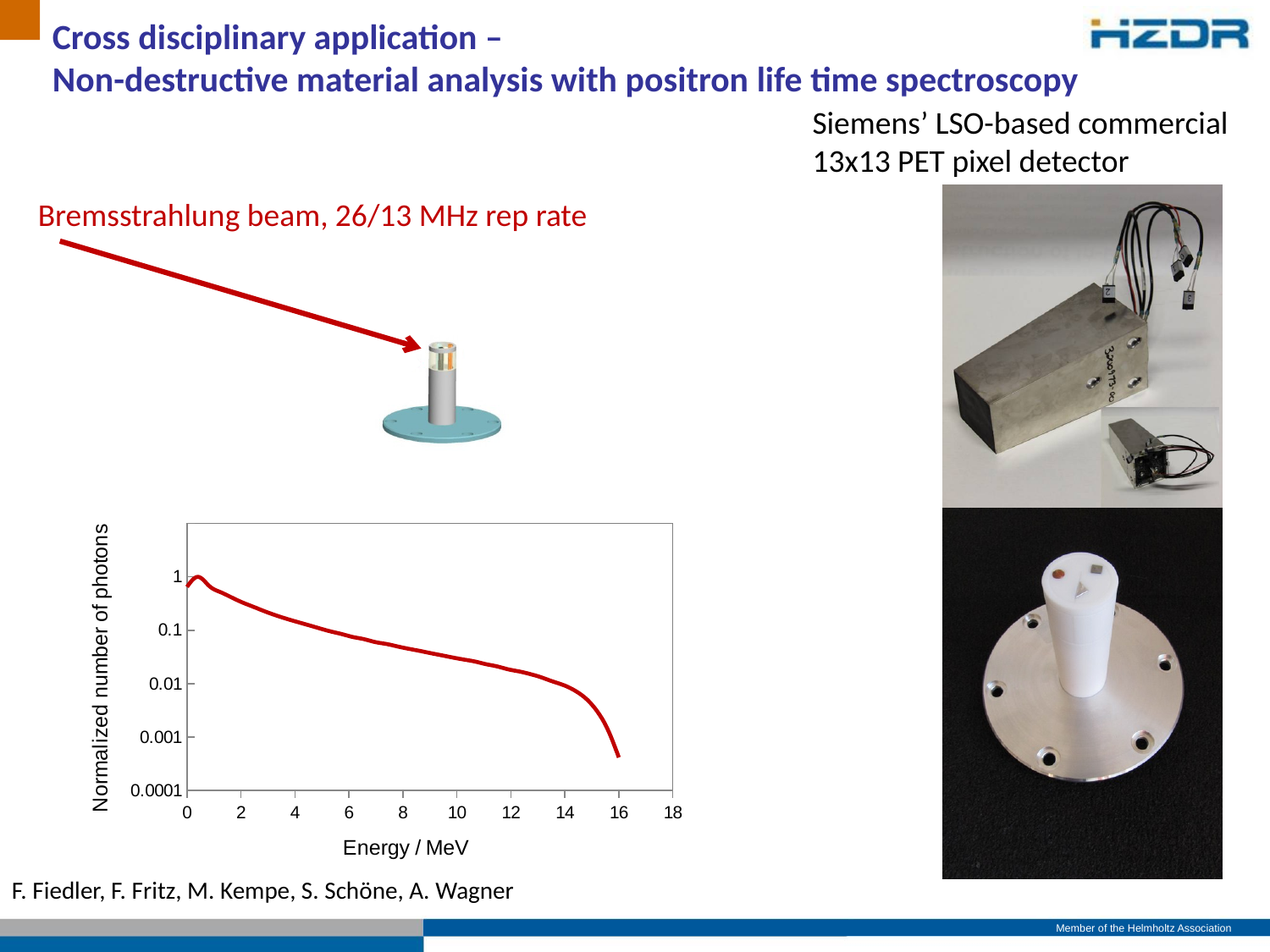
What kind of chart is shown at the bottom left of the slide? line chart How many curves are plotted on the chart? 1 What is the label of the y axis of the chart? Normalized number of photons Is the normalized number of photons at 8 MeV greater or less than 0.01? greater What is the label of the x axis of the chart? Energy / MeV Is the normalized number of photons at 2 MeV greater or less than 0.1? greater Which has the larger normalized number of photons, 4 MeV or 12 MeV? 4 MeV Is the normalized number of photons at 16 MeV greater or less than 0.001? less Does the normalized number of photons rise or fall as energy increases from 2 MeV to 16 MeV? fall Which has the smaller normalized number of photons, 6 MeV or 15 MeV? 15 MeV